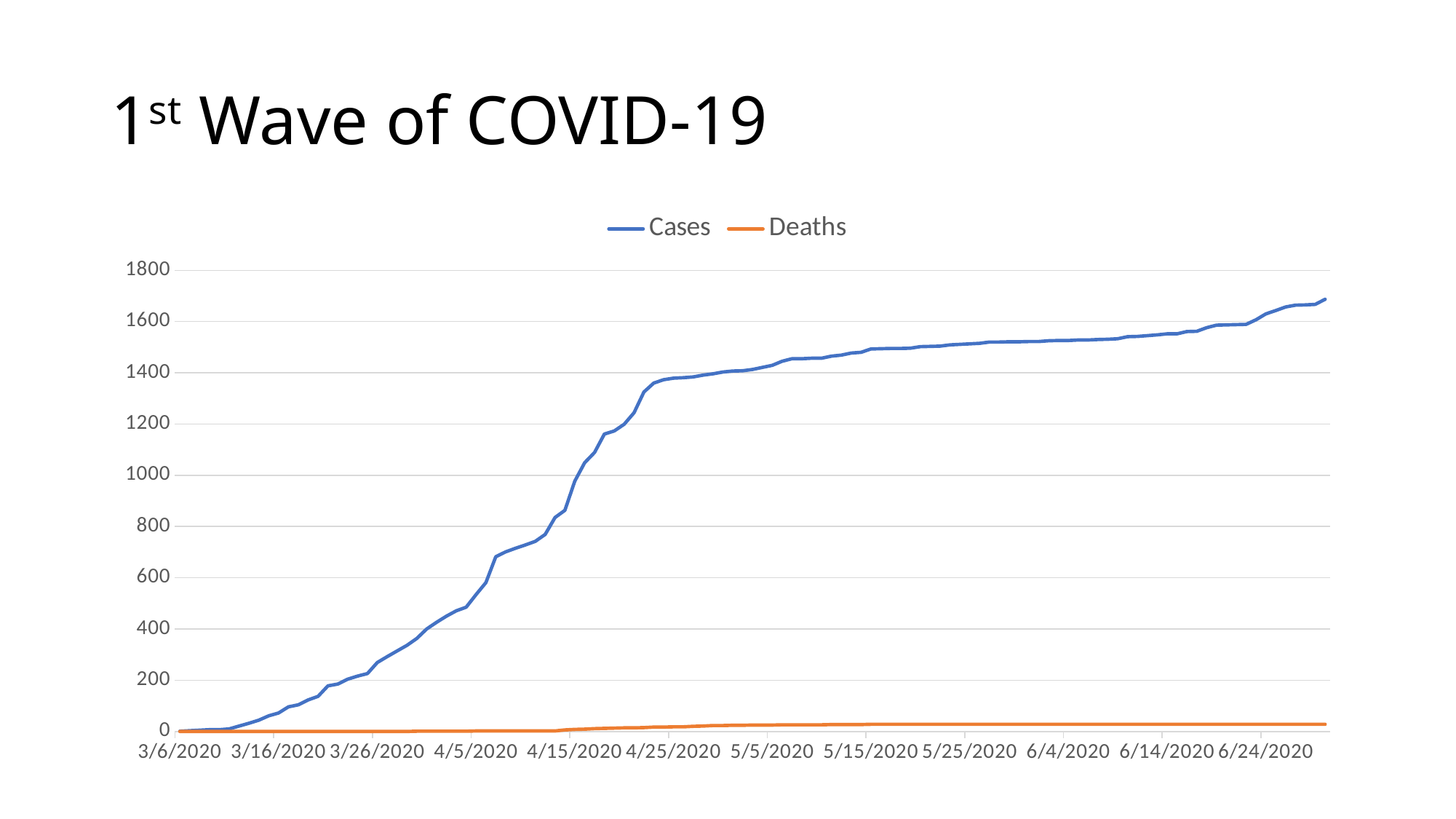
Is the value for Cases on 4/15/2020 greater or less than 800? greater What are the two series named in the legend? Cases and Deaths Is the value for Cases at the last date on the chart greater or less than 1800? less Do the Cases values rise or fall from 3/6/2020 to the end of the x axis? rise Is the value for Cases on 4/5/2020 greater or less than 400? greater Which series has the higher values throughout the chart, Cases or Deaths? Cases What kind of chart is shown on the slide? line chart How many series does the legend list? 2 What is the highest value shown on the vertical axis? 1800 What is the title of the slide containing the chart? 1st Wave of COVID-19